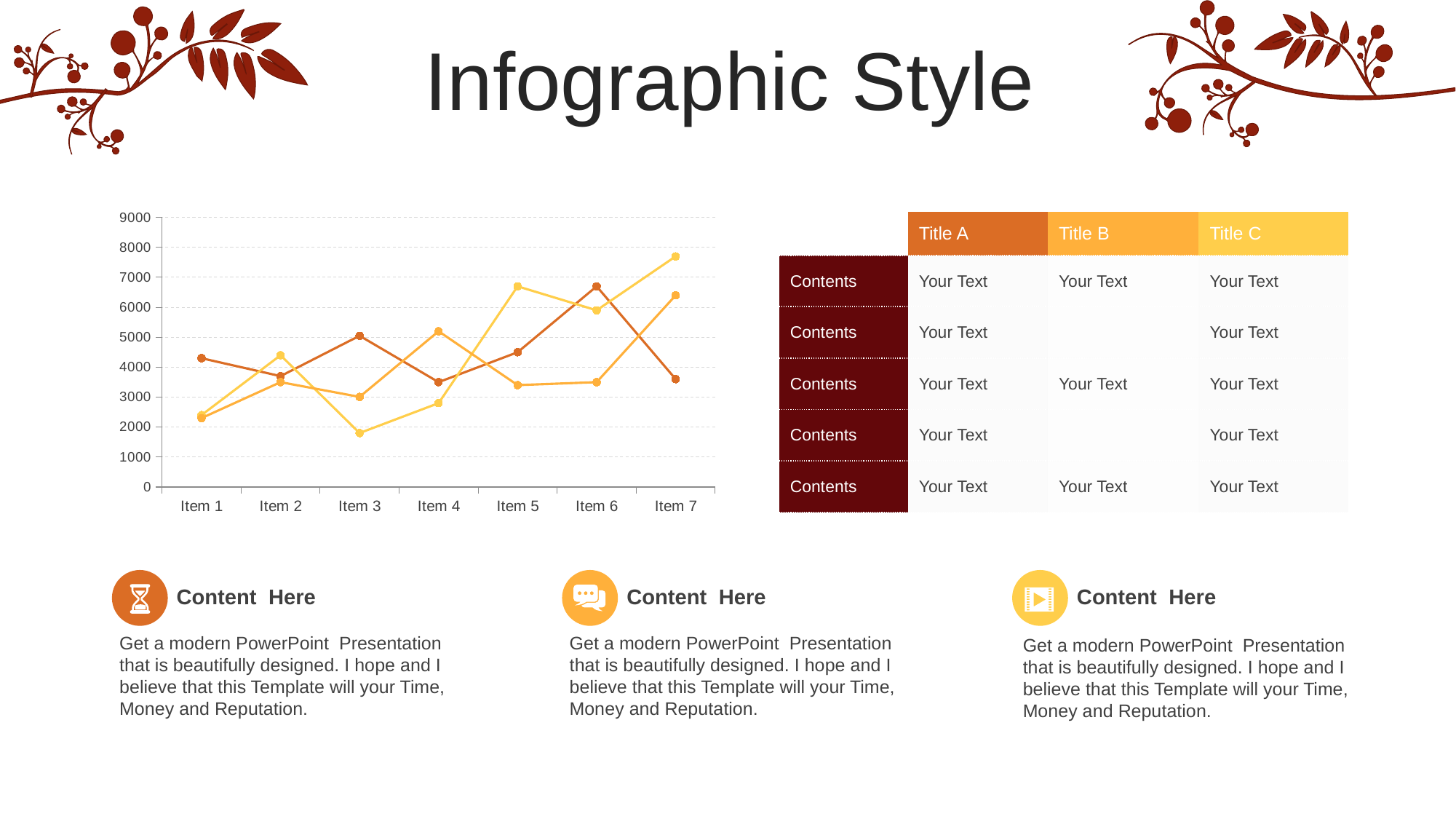
Is the lowest plotted value at Item 3 greater or less than 2000? less Is the lowest plotted value at Item 7 greater or less than 4000? less Is the highest plotted value at Item 7 greater or less than 7000? greater How many lines are plotted on the line chart? 3 What is the highest tick value shown on the vertical axis of the line chart? 9000 What is the label of the last category on the x axis of the line chart? Item 7 What kind of chart is shown on the left of the slide? line chart Which category has the higher maximum plotted value, Item 1 or Item 7? Item 7 How many categories are shown on the x axis of the line chart? 7